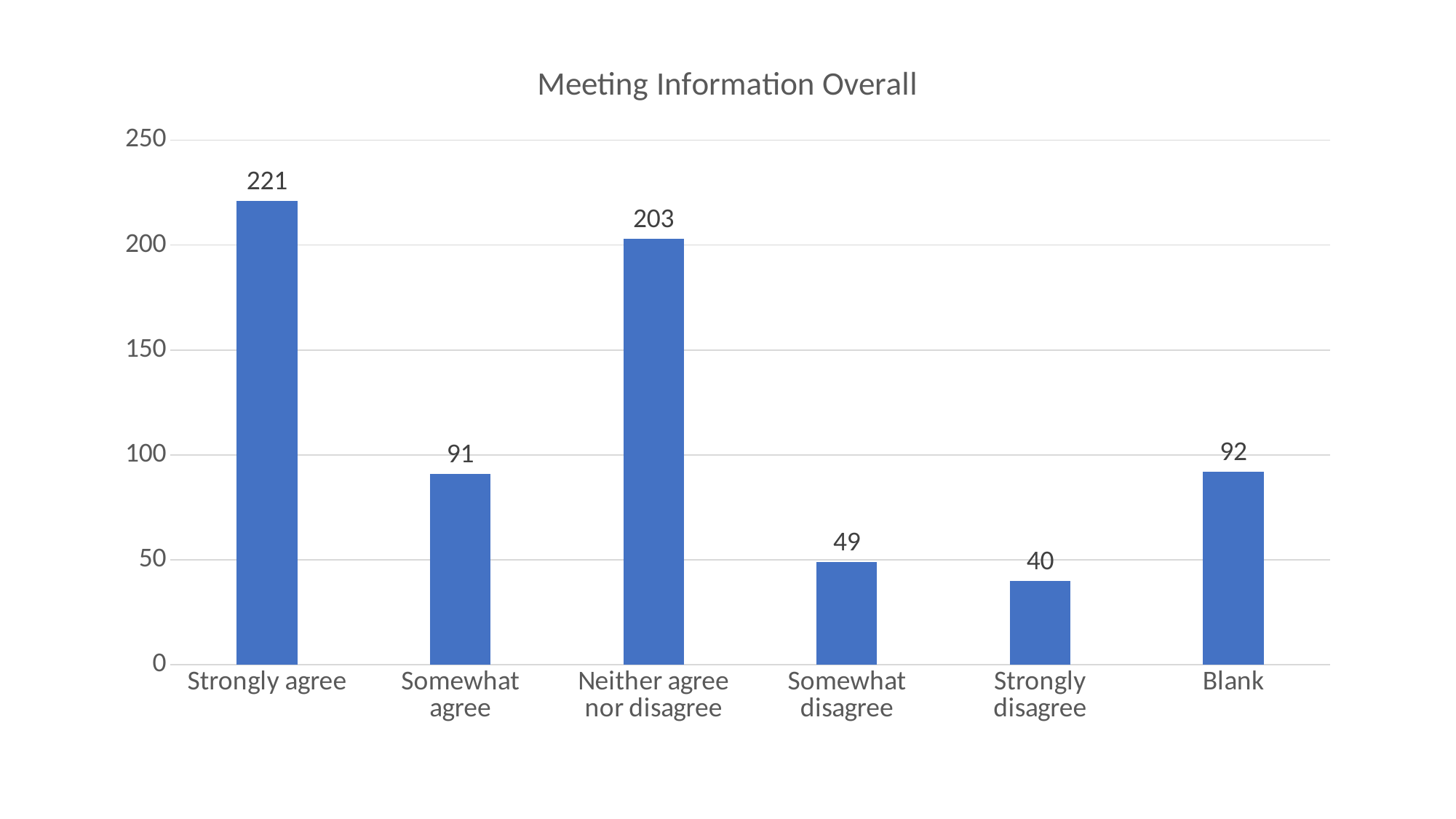
What is the value for Blank? 92 What is the difference between the values for Strongly agree and Neither agree nor disagree? 18 What is the difference between the values for Somewhat disagree and Strongly disagree? 9 How many categories are shown on the x axis? 6 What is the value for Strongly agree? 221 What is the value for Neither agree nor disagree? 203 Which is larger, the value for Somewhat agree or the value for Somewhat disagree? Somewhat agree Which category has the highest value? Strongly agree What is the title of the chart? Meeting Information Overall Is the value for Neither agree nor disagree greater or less than 200? greater Which category has the lowest value? Strongly disagree What is the value for Strongly disagree? 40